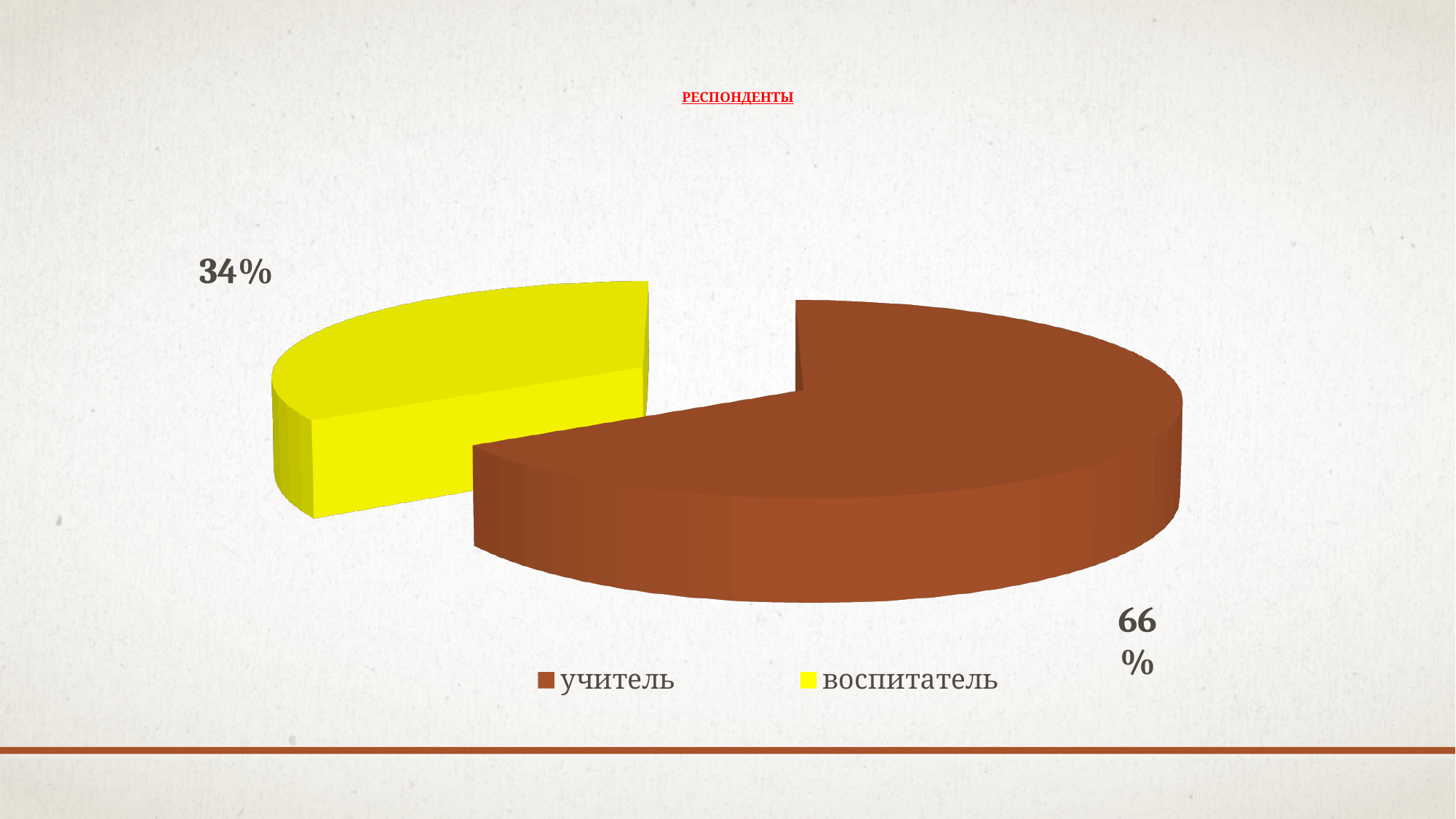
Which is larger, the share for учитель or the share for воспитатель? учитель How many entries does the legend list? 2 What kind of chart is shown on the slide? pie chart What is the title of the chart? РЕСПОНДЕНТЫ What colour is the slice for воспитатель? yellow How many slices does the pie chart have? 2 What share of the pie does учитель have? 66% What is the difference in percentage points between учитель and воспитатель? 32 What share of the pie does воспитатель have? 34% Which category has the largest slice of the pie? учитель Which category has the smallest slice of the pie? воспитатель